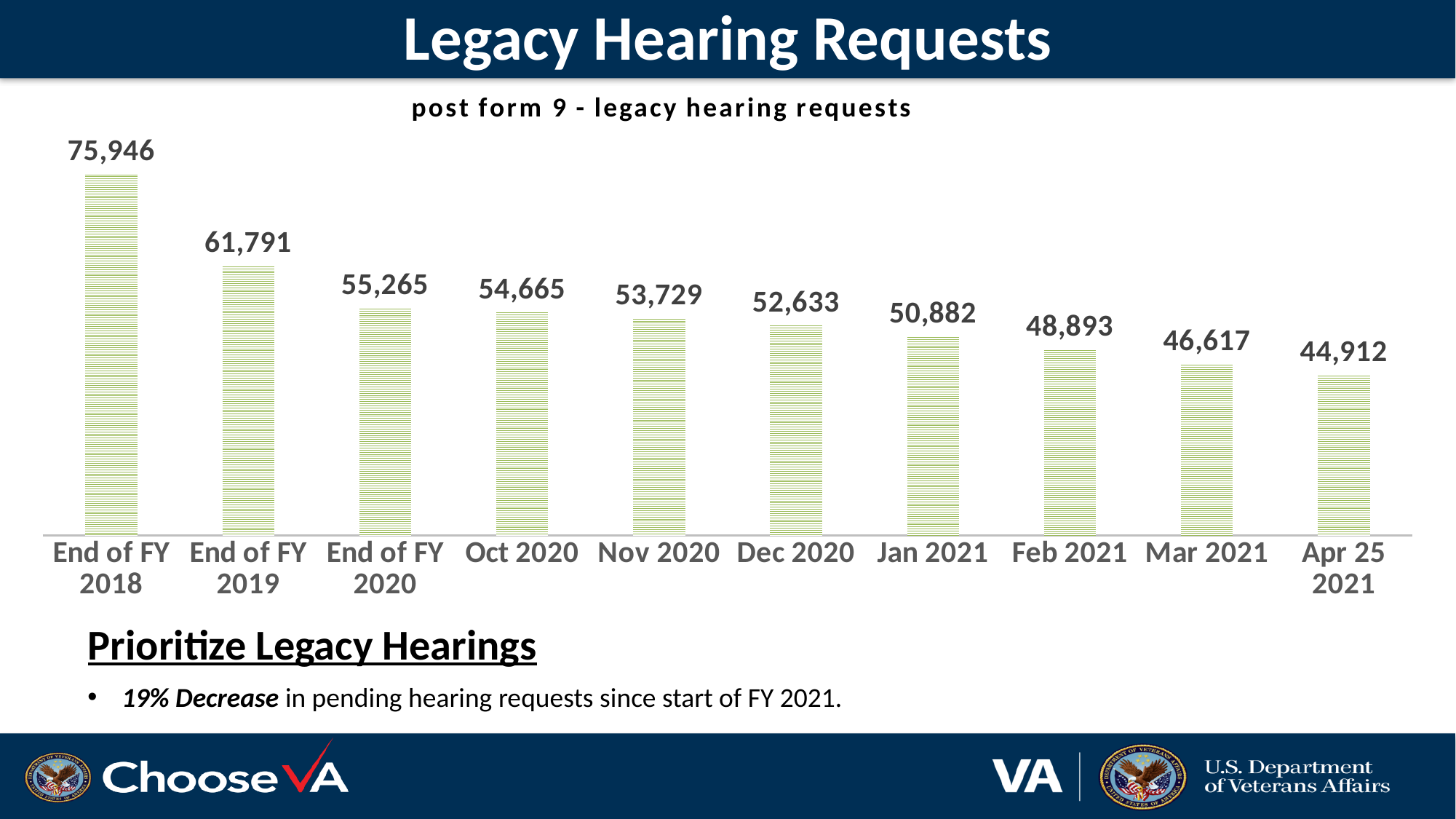
What is the difference between the End of FY 2020 value and the Apr 25 2021 value? 10,353 How many categories are shown on the x axis? 10 What is the title of the chart? post form 9 - legacy hearing requests Do the values rise or fall from left to right along the x axis? Fall Which category has the highest value? End of FY 2018 What is the value for Jan 2021? 50,882 What is the value for End of FY 2018? 75,946 What is the value for Apr 25 2021? 44,912 Which is larger, the value for Nov 2020 or the value for Feb 2021? Nov 2020 What kind of chart is this? Bar chart Which category has the lowest value? Apr 25 2021 What is the difference between the End of FY 2018 value and the End of FY 2019 value? 14,155